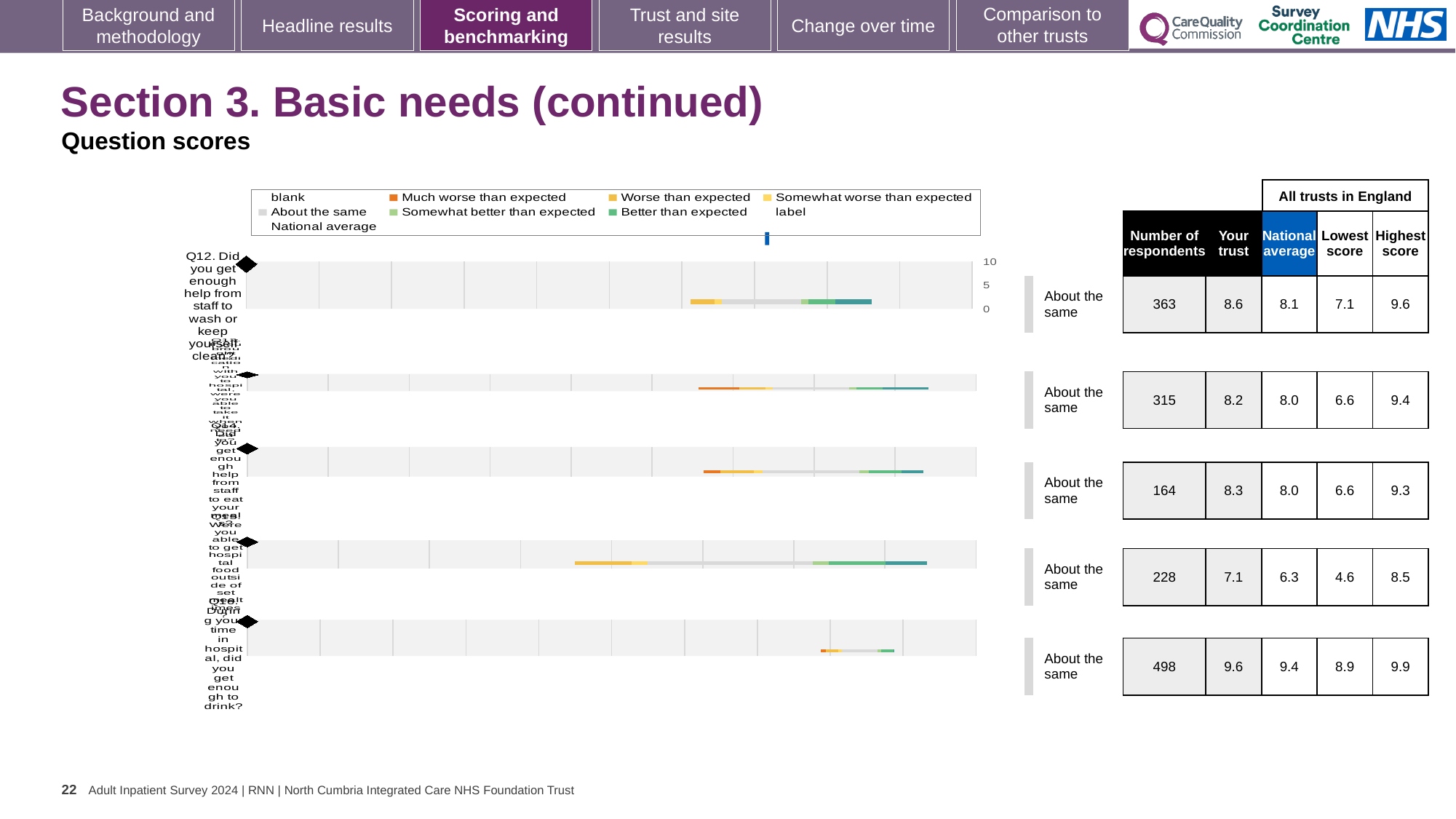
Which legend entry is shown in orange in the chart? Much worse than expected In the table beside the chart, which row has the highest 'Your trust' score? Q16 (9.6) In the table beside the chart, what is the 'Your trust' score for the top row (Q12)? 8.6 What is the label of the first (top) bar in the chart? Q12. Did you get enough help from staff to wash or keep yourself clean? What kind of chart is shown on the slide? bar chart What benchmark category is shown next to the chart for every question bar? About the same In the table beside the chart, which row has the lowest 'Your trust' score? Q15 (7.1) How many question bars are plotted in the chart? 5 In the table beside the chart, what is the difference between the 'Your trust' score and the national average for the top row (Q12)? 0.5 How many entries does the chart legend list? 9 In the table beside the chart, what is the national average for the fourth row (Q15, hospital food outside of set meal times)? 6.3 In the table beside the chart, what is the number of respondents for the bottom row (Q16, enough to drink)? 498